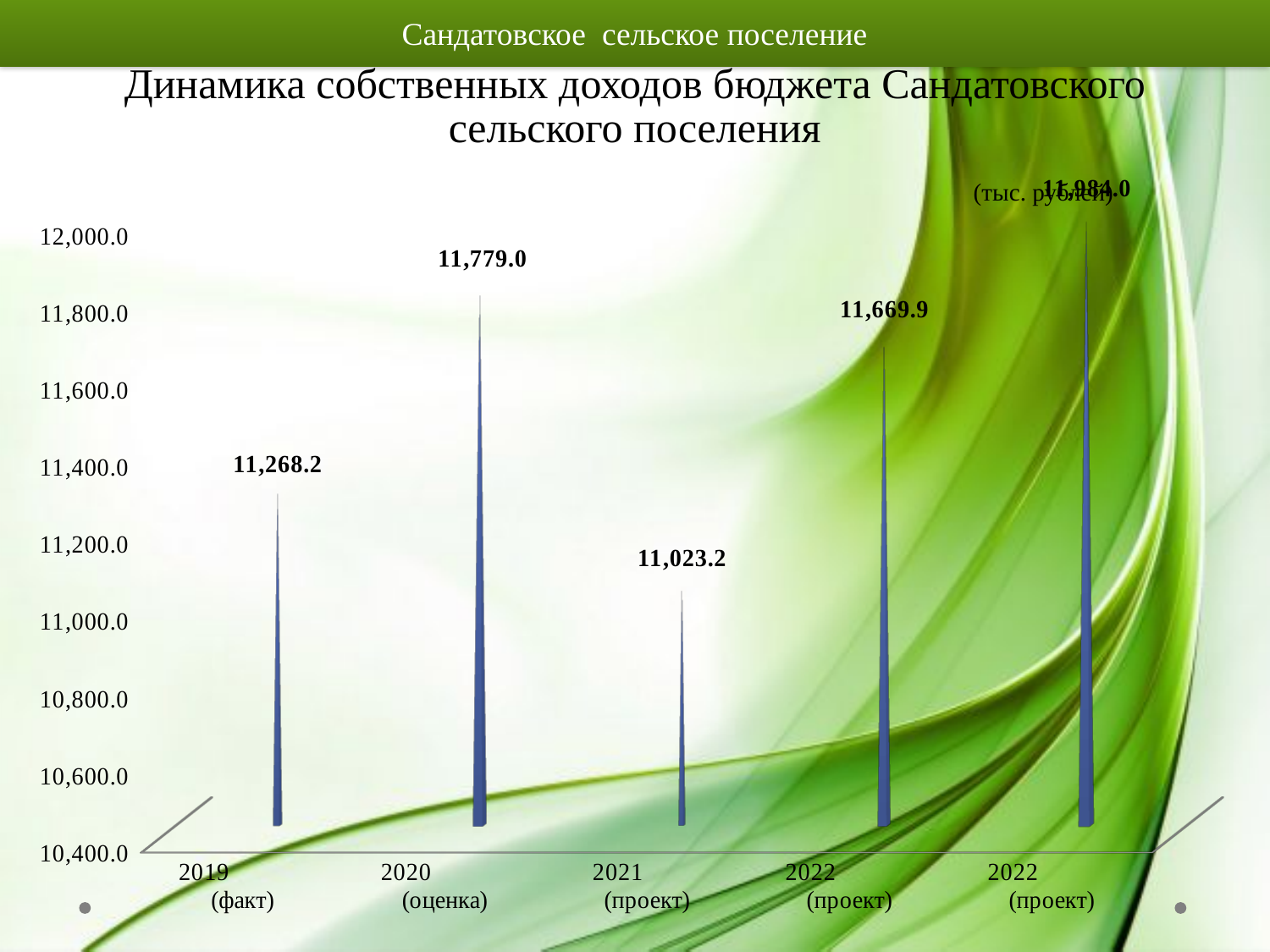
What is the difference between the values for 2020 (оценка) and 2021 (проект)? 755.8 Which is larger, the value for 2019 (факт) or the value for 2021 (проект)? 2019 (факт) How many bars are shown in the chart? 5 Is the value for 2021 (проект) greater or less than 11,200.0? less What is the value for 2020 (оценка)? 11,779.0 What kind of chart is shown on the slide? bar chart Which category has the lowest value? 2021 (проект) What is the difference between the values for 2020 (оценка) and 2019 (факт)? 510.8 What is the value of the fourth bar from the left (the first one labelled 2022 (проект))? 11,669.9 What is the value for 2021 (проект)? 11,023.2 Which bar has the highest value? the rightmost (fifth) bar, 2022 (проект) What is the value for 2019 (факт)? 11,268.2